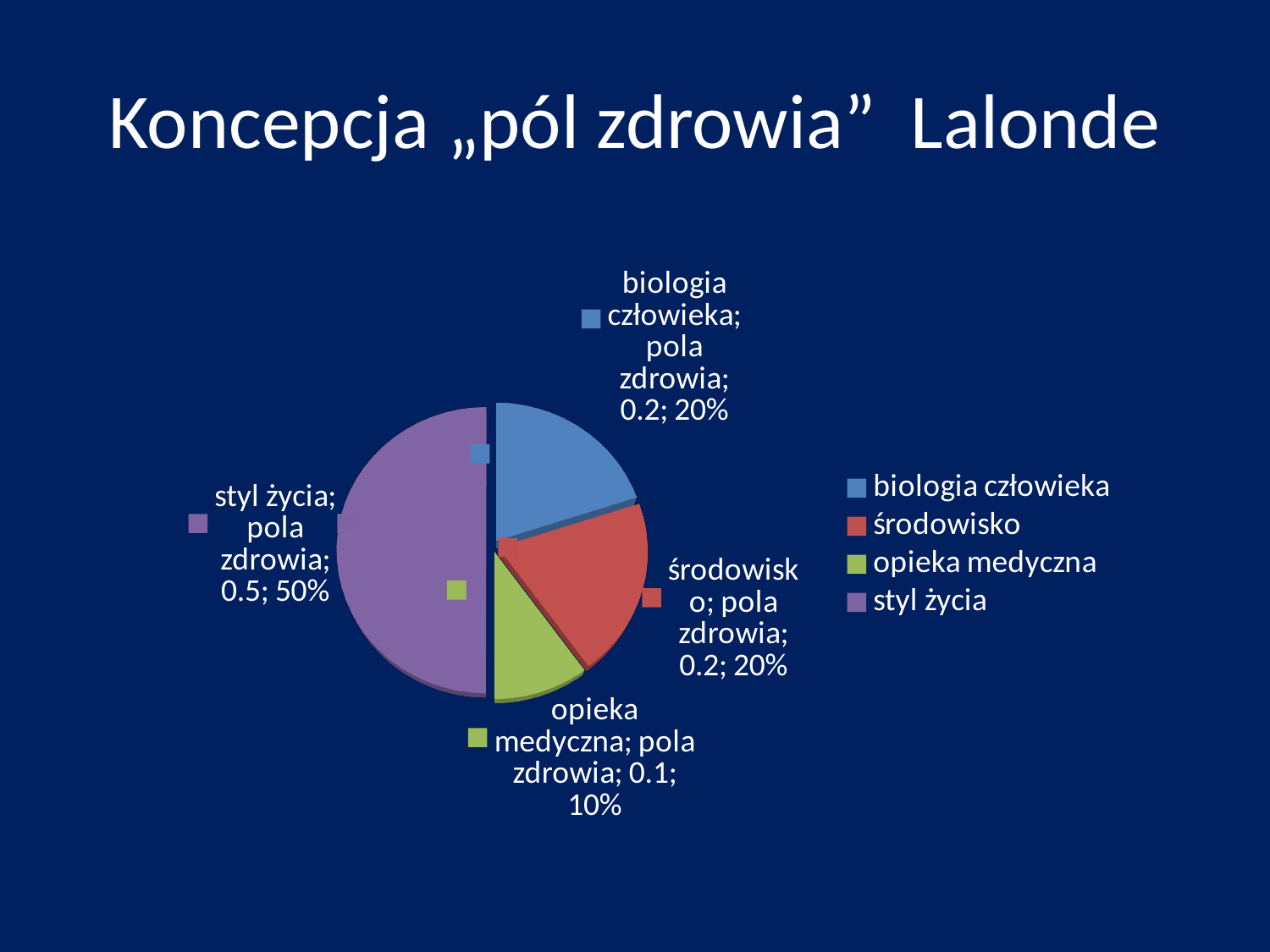
How many categories are shown in the pie chart? 4 Which is larger, the slice for 'środowisko' or the slice for 'opieka medyczna'? środowisko Which category has the smallest slice of the pie? opieka medyczna What is the title of the slide containing the chart? Koncepcja „pól zdrowia" Lalonde What is the value shown for 'środowisko'? 0.2 What kind of chart is shown on the slide? pie chart Which category has the largest slice of the pie? styl życia What share of the pie does the 'styl życia' slice represent? 50% What colour is the 'styl życia' slice in the pie chart? purple What percentage is shown for 'biologia człowieka'? 20% What is the value shown for 'opieka medyczna'? 0.1 What is the difference between the values for 'styl życia' and 'opieka medyczna'? 0.4